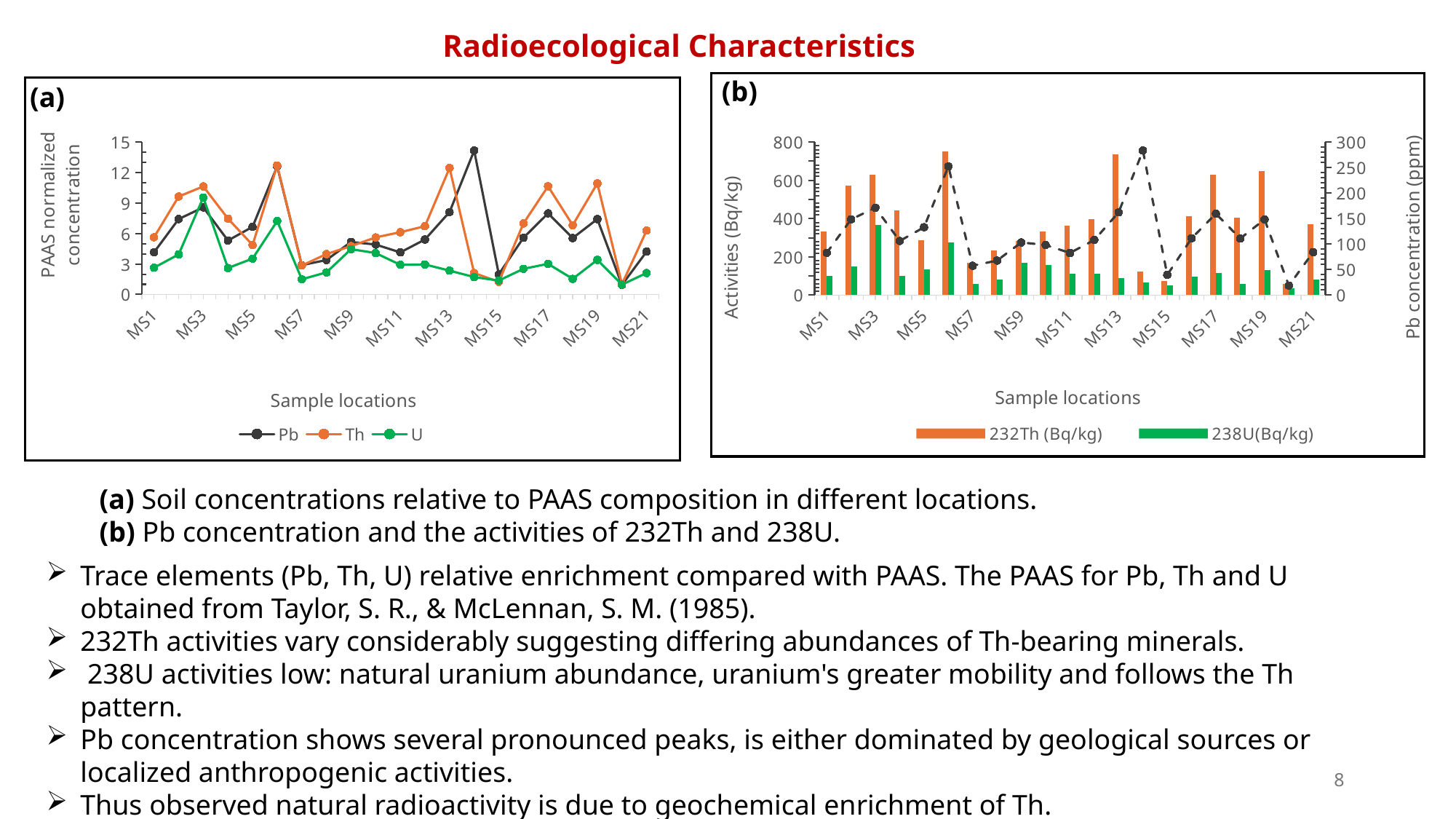
In chart (b), at which sample location is the 238U (Bq/kg) bar the tallest? MS3 In chart (a), at which sample location does the Pb series reach its highest value? MS14 How many series does the legend of chart (a) list? 3 In chart (b), at MS3, which bar is taller, 232Th (Bq/kg) or 238U(Bq/kg)? 232Th (Bq/kg) In chart (a), at which sample location does the U series reach its highest value? MS3 In chart (a), at MS5, which series has the larger value, Th or U? Th In chart (b), is the 232Th (Bq/kg) value at MS1 greater or less than 400? less How many series does the legend of chart (b) list? 2 What is the x-axis title of chart (b)? Sample locations How many sample locations are plotted along the x axis of chart (a)? 21 What kind of chart is chart (a)? line chart In chart (a), is the Pb value at MS14 greater or less than 12? greater